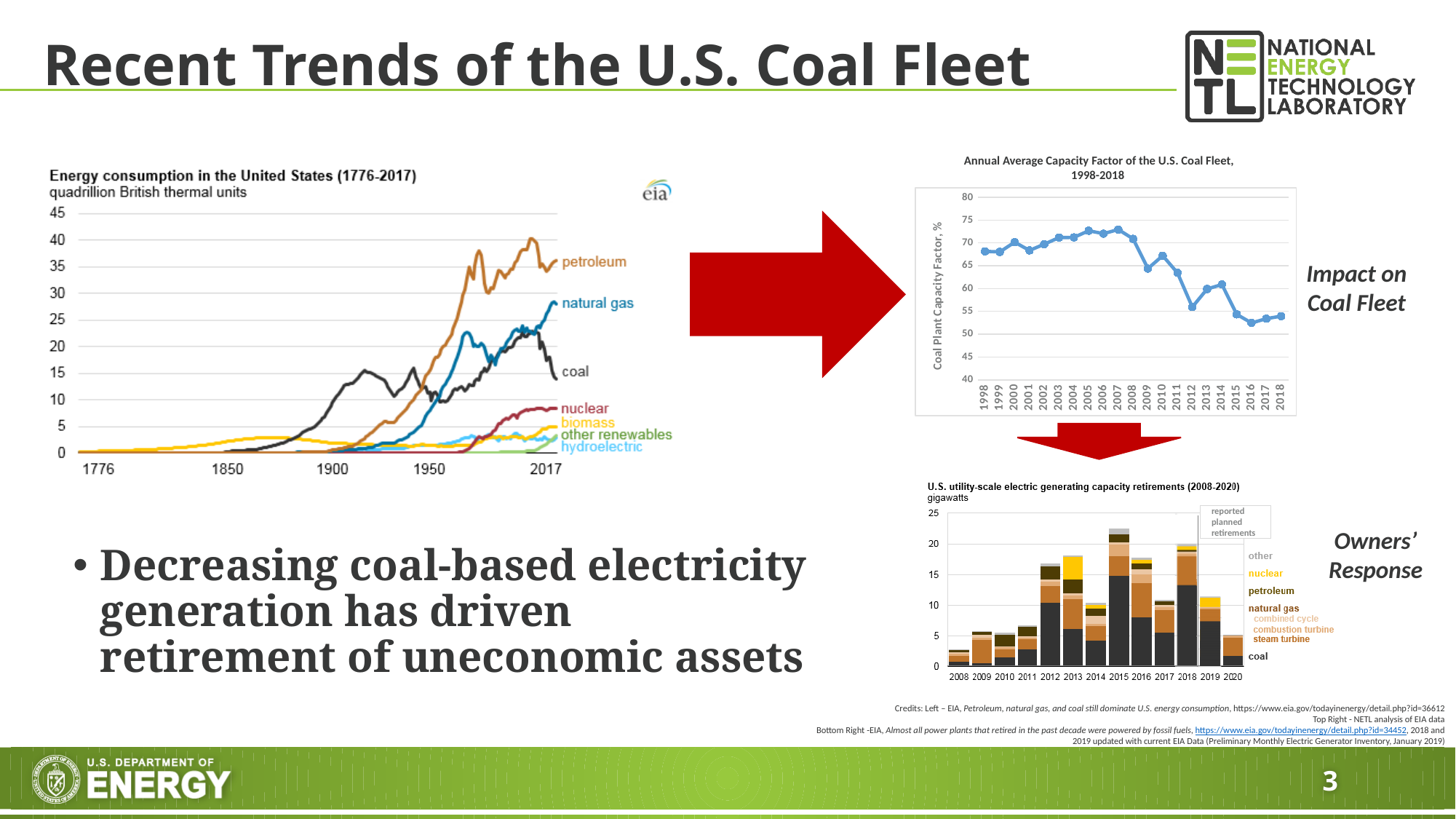
In the 'Energy consumption in the United States' chart, is the value for coal in 2017 greater or less than 20? less In the 'Energy consumption in the United States' chart, which energy source has the highest consumption in 2017? petroleum In the 'Annual Average Capacity Factor of the U.S. Coal Fleet, 1998-2018' chart, which year has the lowest capacity factor? 2016 In the 'Annual Average Capacity Factor of the U.S. Coal Fleet' chart, does the capacity factor overall rise or fall from 1998 to 2018? fall What kind of chart is the 'U.S. utility-scale electric generating capacity retirements (2008-2020)' chart? bar chart In the 'Energy consumption in the United States' chart, how many energy sources are labelled? 7 In the 'Annual Average Capacity Factor of the U.S. Coal Fleet' chart, is the value for 1998 greater or less than 65? greater In the 'U.S. utility-scale electric generating capacity retirements' chart, which year has the highest total retirements? 2015 In the 'Energy consumption in the United States' chart, is the value for petroleum in 2017 greater or less than 30? greater What kind of chart is the 'Energy consumption in the United States (1776-2017)' chart on the left? line chart In the 'U.S. utility-scale electric generating capacity retirements' chart, which year has larger total retirements, 2018 or 2019? 2018 What unit is used on the 'Energy consumption in the United States' chart? quadrillion British thermal units